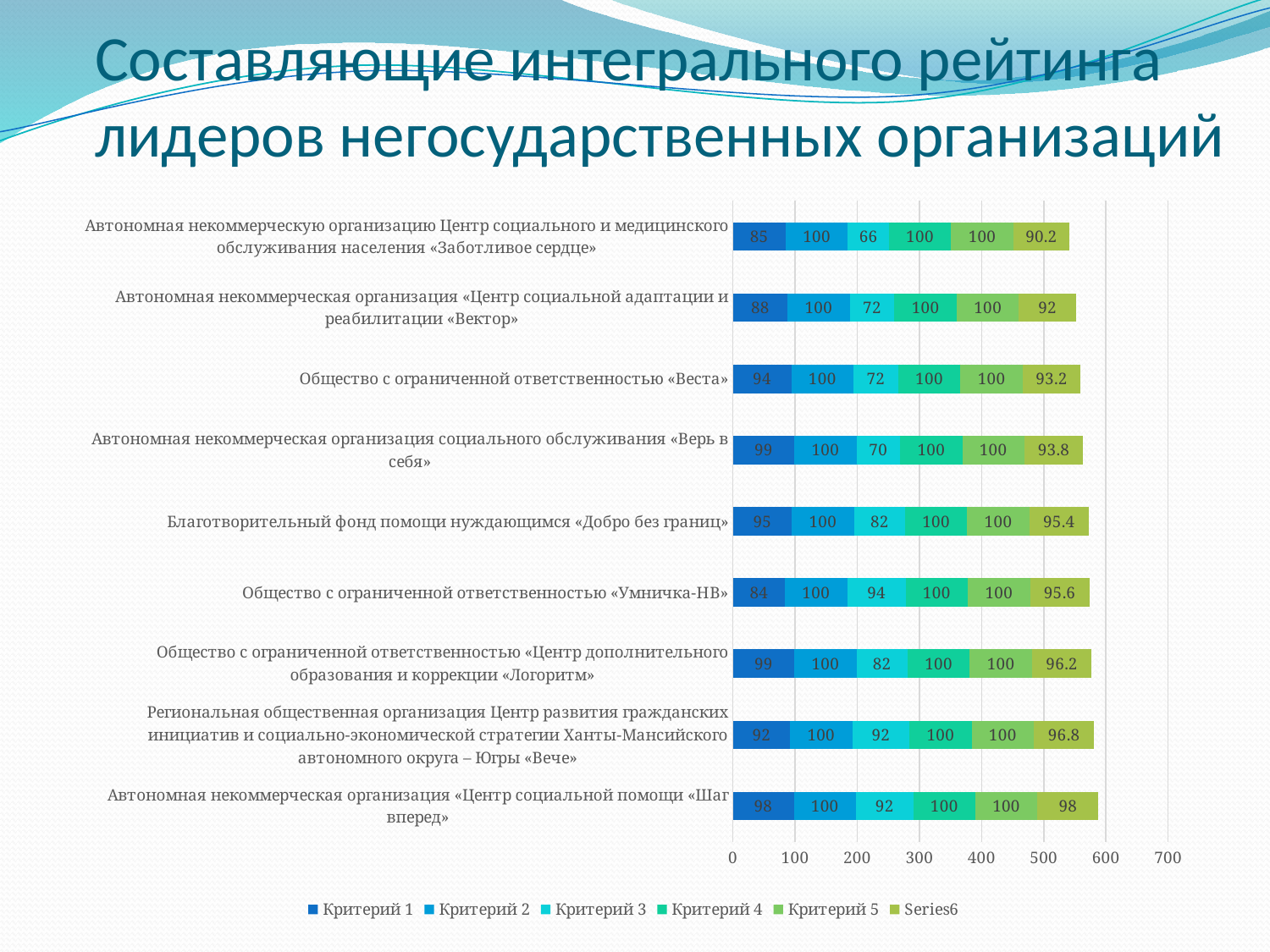
Which organisation has the highest Series6 value? Автономная некоммерческая организация «Центр социальной помощи «Шаг вперед» What is the total of the stacked bar for Автономная некоммерческая организация «Центр социальной помощи «Шаг вперед»? 588 How many series does the legend list? 6 What is the difference between the Критерий 1 values of «Верь в себя» and «Умничка-НВ»? 15 Which organisation has the lowest Критерий 3 value? Автономная некоммерческую организацию Центр социального и медицинского обслуживания населения «Заботливое сердце» What is the name of the last series listed in the legend? Series6 Which is larger: the Критерий 3 value for «Вектор» or for «Логоритм»? «Логоритм» What is the value of Критерий 3 for Общество с ограниченной ответственностью «Умничка-НВ»? 94 What type of chart is shown on the slide? Stacked bar chart What is the Series6 value for Благотворительный фонд помощи нуждающимся «Добро без границ»? 95.4 How many organisations (categories) are plotted in the chart? 9 What is the value of Критерий 1 for Общество с ограниченной ответственностью «Веста»? 94